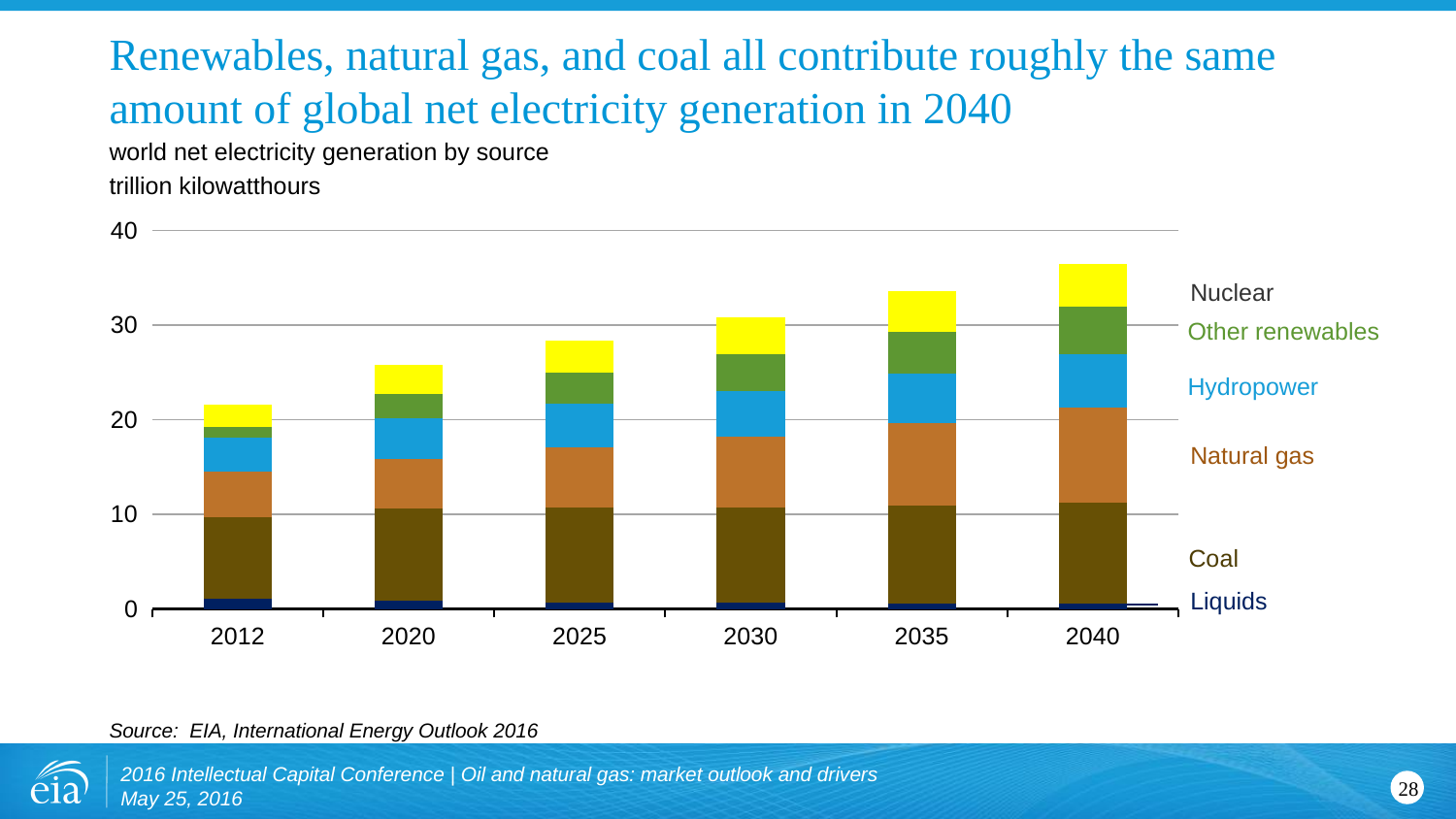
Is the total stacked bar for 2040 greater or less than 30 trillion kilowatthours? greater How many series does the chart's legend list? 6 What unit is the chart's y axis measured in, according to the subtitle? trillion kilowatthours Which series is shown at the bottom of each stacked bar, according to the legend? Liquids How many years are shown along the x axis of the chart? 6 What kind of chart is shown on the slide? stacked bar chart Is the total stacked bar for 2012 greater or less than 30 trillion kilowatthours? less Which year has the shortest stacked bar (lowest total net electricity generation)? 2012 Is the total stacked bar for 2020 greater or less than 30 trillion kilowatthours? less Does total world net electricity generation rise or fall from 2012 to 2040? rise Which is larger, the total stacked bar for 2040 or for 2012? 2040 Which year has the tallest stacked bar (highest total net electricity generation)? 2040